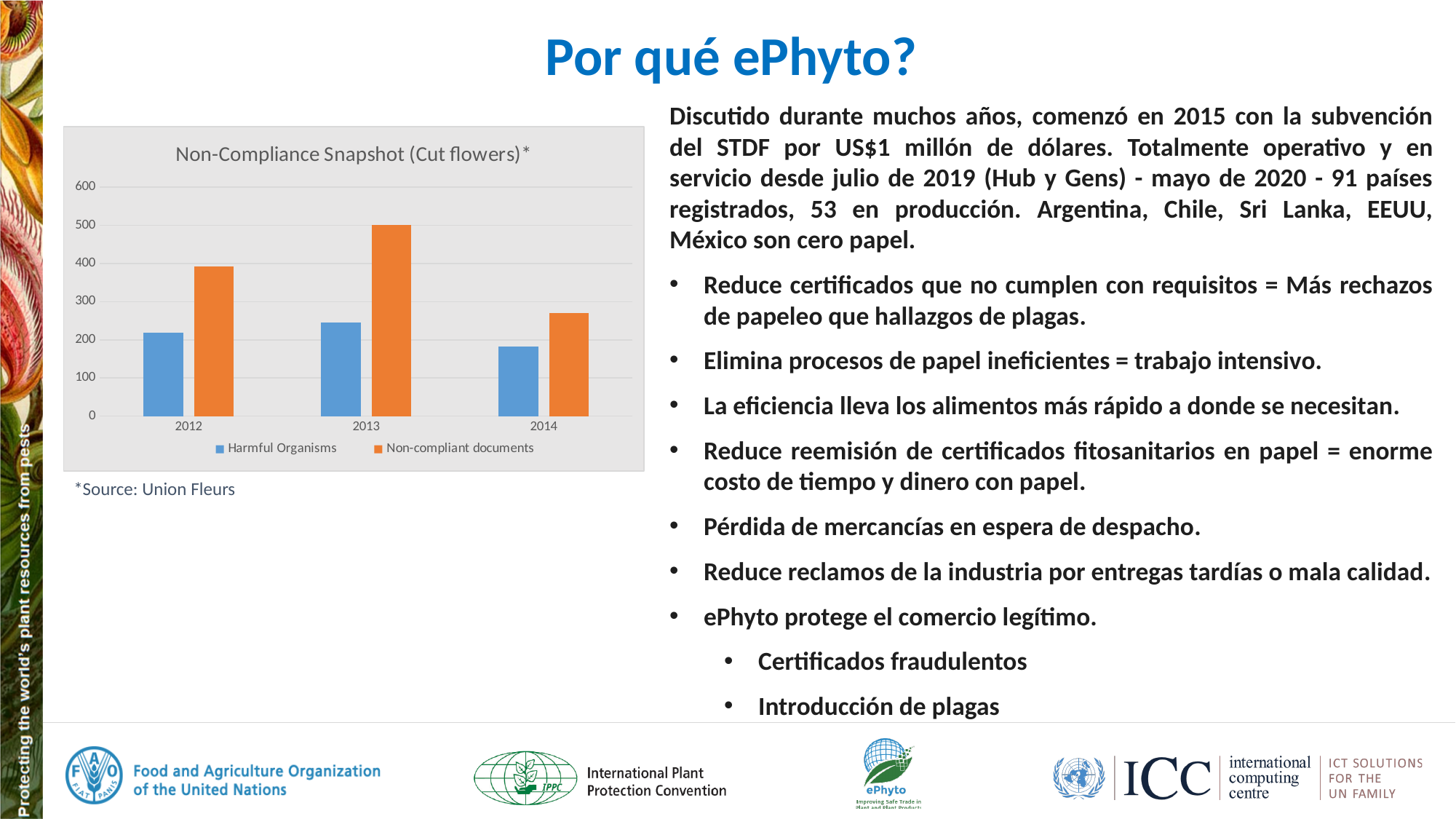
In 2012, which is larger: Harmful Organisms or Non-compliant documents? Non-compliant documents How many series does the chart legend list? 2 Is the value for Non-compliant documents in 2013 greater or less than 400? greater In which year is the Non-compliant documents bar highest? 2013 In which year is the Harmful Organisms bar lowest? 2014 In which year is the Non-compliant documents bar lowest? 2014 How many years are shown on the x axis of the chart? 3 Does the Non-compliant documents value rise or fall from 2013 to 2014? fall Is the value for Harmful Organisms in 2014 greater or less than 200? less What kind of chart is shown on the slide? bar chart What is the title of the chart? Non-Compliance Snapshot (Cut flowers)* Is the value for Non-compliant documents in 2012 greater or less than 300? greater